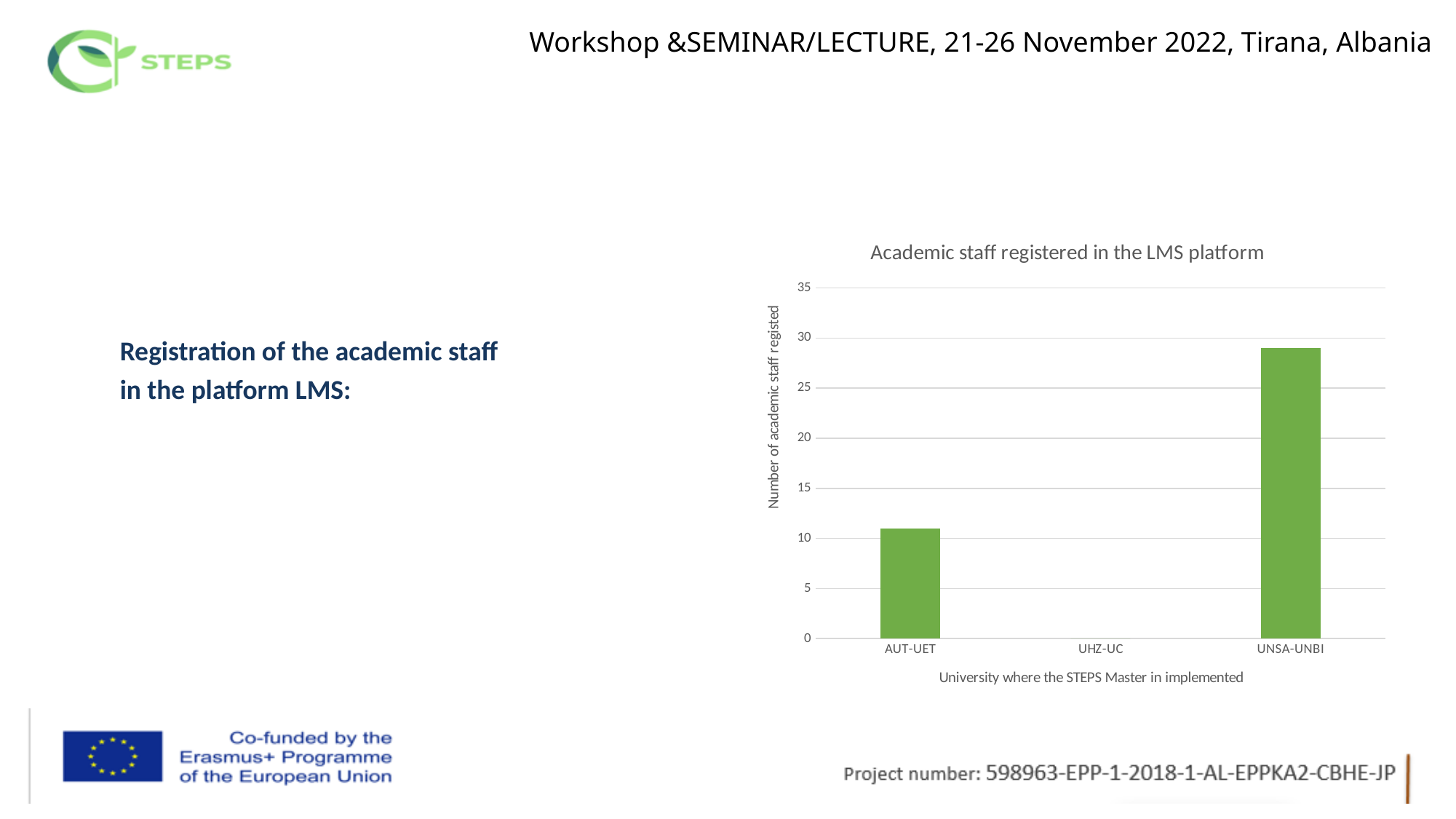
What is the title of the chart? Academic staff registered in the LMS platform What is the label of the x axis of the chart? University where the STEPS Master in implemented Is the value for AUT-UET greater or less than 15? less Which university has the lowest number of academic staff registered in the LMS platform? UHZ-UC What kind of chart is shown on the slide? bar chart Is the value for UNSA-UNBI greater or less than 30? less How many universities are shown on the x axis of the chart? 3 Which university has the highest number of academic staff registered in the LMS platform? UNSA-UNBI Which has more academic staff registered, AUT-UET or UNSA-UNBI? UNSA-UNBI Is the value for AUT-UET greater or less than 10? greater